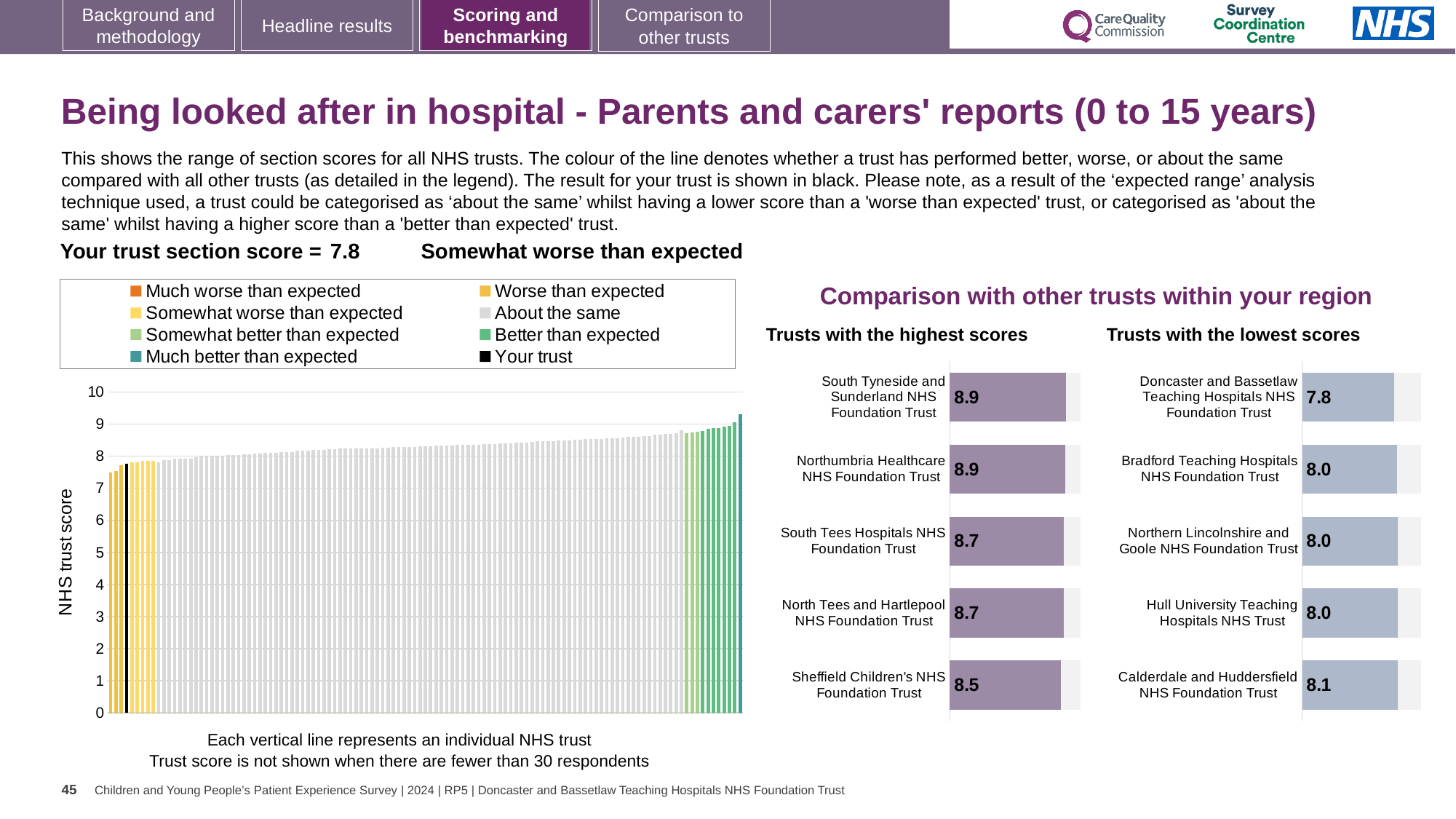
In the 'Trusts with the lowest scores' chart, what is the difference between the scores of Calderdale and Huddersfield NHS Foundation Trust and Doncaster and Bassetlaw Teaching Hospitals NHS Foundation Trust? 0.3 In the 'Trusts with the lowest scores' chart, what is the score for Calderdale and Huddersfield NHS Foundation Trust? 8.1 In the 'Trusts with the highest scores' chart, what is the score for Sheffield Children's NHS Foundation Trust? 8.5 In the 'Trusts with the lowest scores' chart, which trust has the lowest score? Doncaster and Bassetlaw Teaching Hospitals NHS Foundation Trust How many trusts are listed in the 'Trusts with the lowest scores' chart? 5 In the 'Trusts with the highest scores' chart, what is the score for South Tees Hospitals NHS Foundation Trust? 8.7 In the 'Trusts with the highest scores' chart, which has the larger score: Northumbria Healthcare NHS Foundation Trust or North Tees and Hartlepool NHS Foundation Trust? Northumbria Healthcare NHS Foundation Trust In the 'Trusts with the lowest scores' chart, which trust has the highest score? Calderdale and Huddersfield NHS Foundation Trust In the 'Trusts with the highest scores' chart, which trust has the lowest score? Sheffield Children's NHS Foundation Trust In the main chart on the left showing the range of section scores, do the trust scores rise or fall from left to right? rise How many entries does the legend of the main chart on the left list? 8 In the 'Trusts with the highest scores' chart, what is the difference between the scores of South Tyneside and Sunderland NHS Foundation Trust and Sheffield Children's NHS Foundation Trust? 0.4